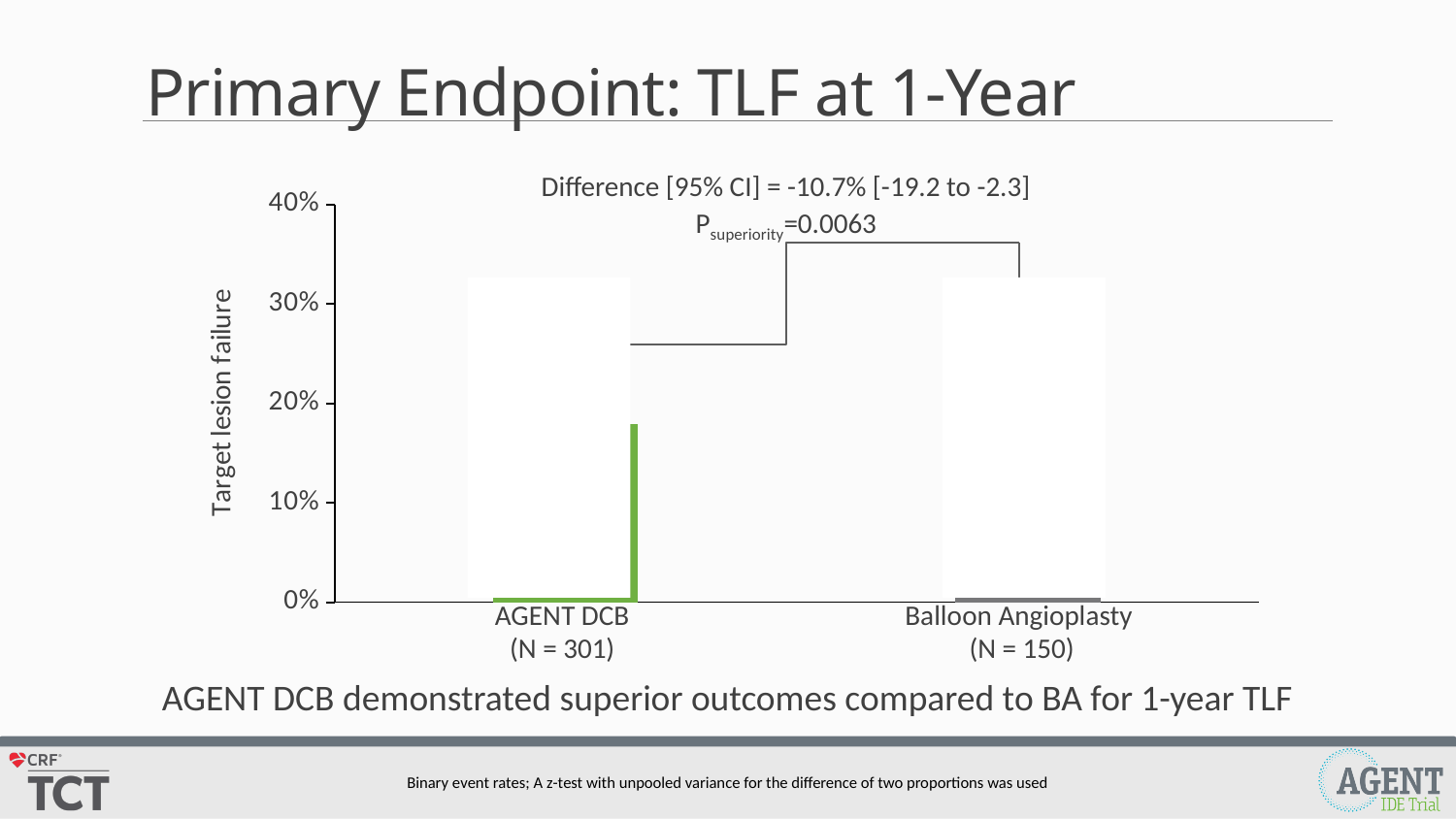
What type of chart is shown on the slide? bar chart What is the P superiority value shown on the chart? 0.0063 What is the difference [95% CI] reported above the chart? -10.7% [-19.2 to -2.3] What is the title of the slide containing the chart? Primary Endpoint: TLF at 1-Year What is the N for the AGENT DCB group? 301 What is the difference in N between the AGENT DCB group and the Balloon Angioplasty group? 151 What is the lower bound of the 95% confidence interval for the difference? -19.2 What is the N for the Balloon Angioplasty group? 150 What is the upper bound of the 95% confidence interval for the difference? -2.3 Which group has the larger N, AGENT DCB or Balloon Angioplasty? AGENT DCB What is the label on the y axis of the chart? Target lesion failure How many categories are shown on the x axis of the chart? 2